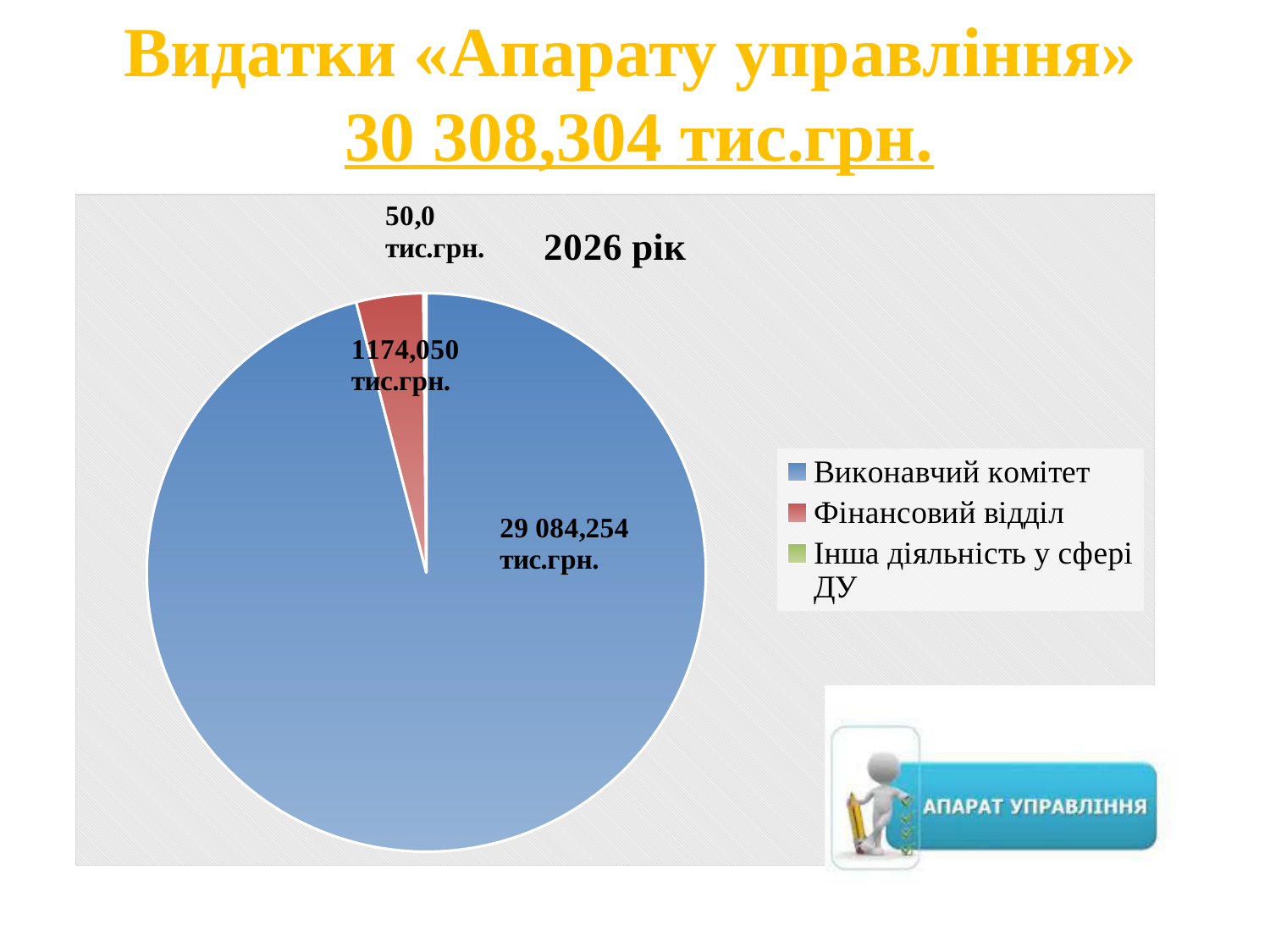
What is the difference between the value for Виконавчий комітет and the value for Фінансовий відділ? 27 910,204 тис.грн. What type of chart is shown on the slide? Pie chart How many entries does the legend list? 3 What is the value for Інша діяльність у сфері ДУ? 50,0 тис.грн. What year is shown as the chart title? 2026 рік Which category has the largest slice of the pie? Виконавчий комітет What is the value for Виконавчий комітет? 29 084,254 тис.грн. Which category has the smallest slice of the pie? Інша діяльність у сфері ДУ What is the total of all slices in the pie chart? 30 308,304 тис.грн. Which is larger, the value for Фінансовий відділ or the value for Інша діяльність у сфері ДУ? Фінансовий відділ How many categories does the pie chart show? 3 What is the value for Фінансовий відділ? 1174,050 тис.грн.